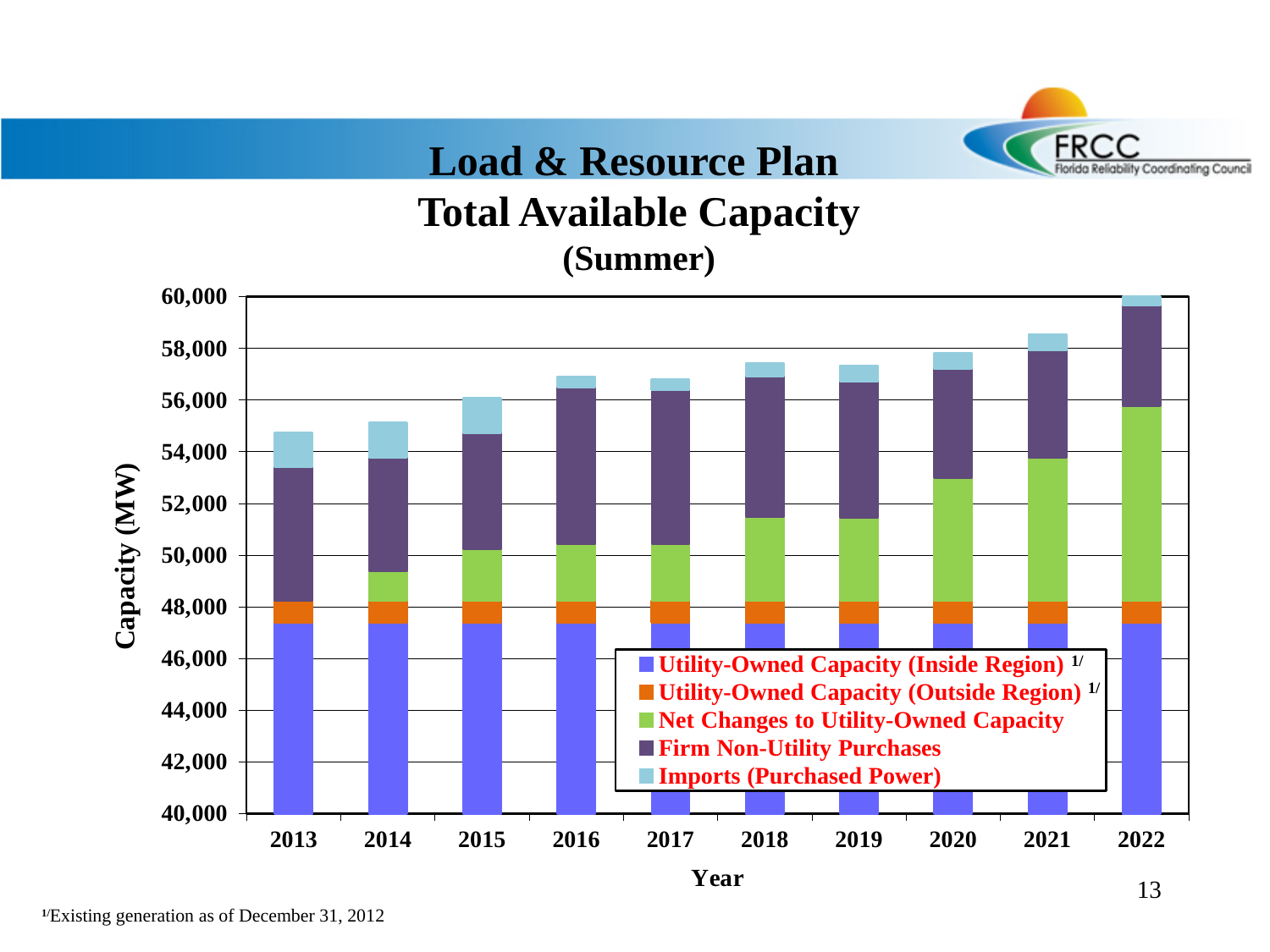
What is the label of the chart's vertical axis? Capacity (MW) Is the total available capacity for 2022 larger or smaller than that for 2013? larger Is the Utility-Owned Capacity (Inside Region) segment for 2013 greater or less than 46,000? greater How many series does the chart's legend list? 5 Which legend entry is shown in green? Net Changes to Utility-Owned Capacity Which year has the highest total available capacity? 2022 Is the total available capacity for 2013 greater or less than 56,000? less Is the total available capacity for 2020 greater or less than 56,000? greater Does the total available capacity generally rise or fall from 2013 to 2022? rise What kind of chart is shown on the slide? Stacked bar chart How many years are shown along the x axis of the chart? 10